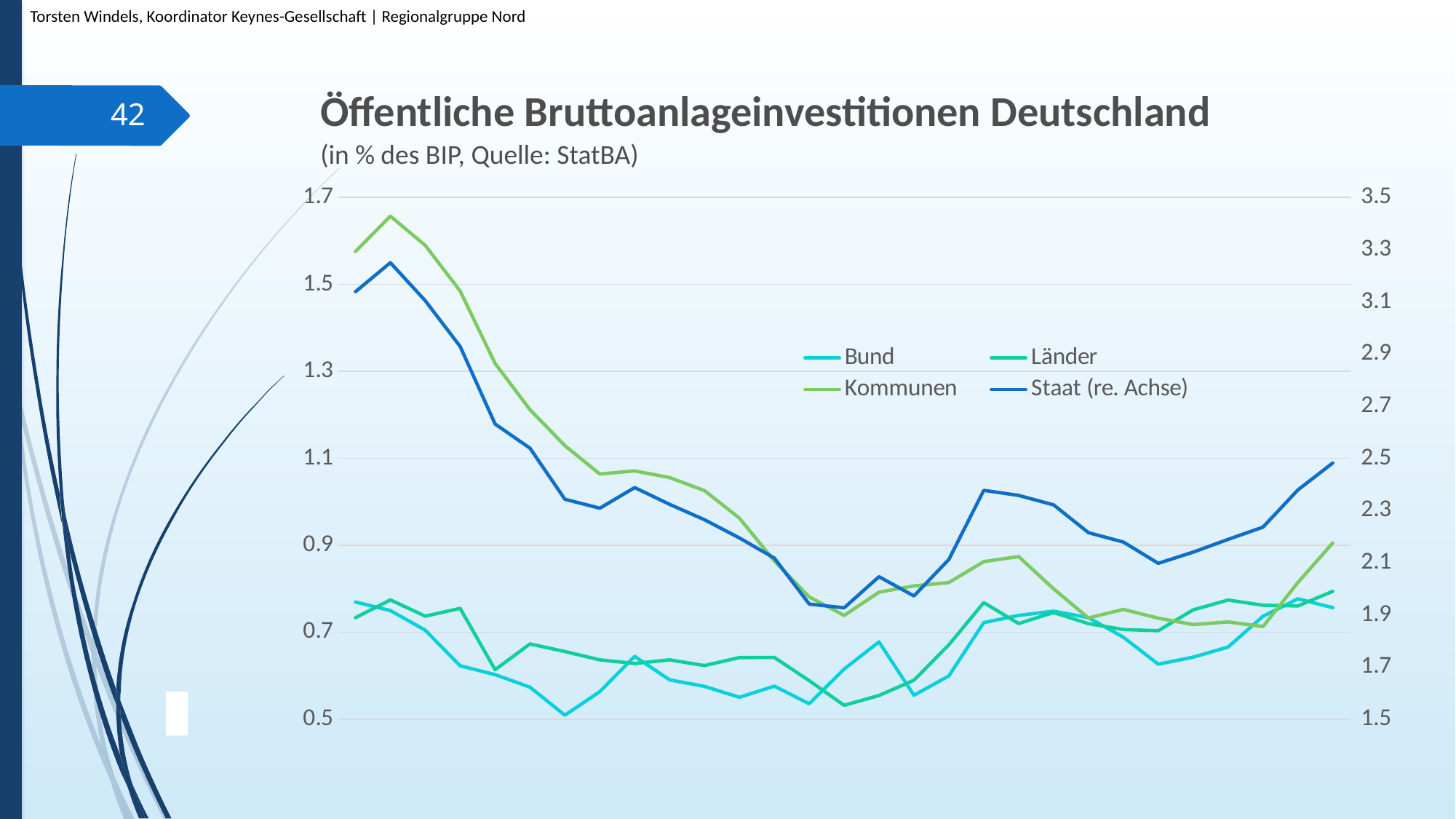
Is the last value of the Staat (re. Achse) series greater or less than 2.3 on the right axis? greater Is the first value of the Kommunen series greater or less than 1.5? greater What kind of chart is shown on the slide? line chart How many series does the legend list? 4 Is the lowest value of the Staat (re. Achse) series greater or less than 2.1 on the right axis? less Does the Kommunen series overall rise or fall from the start to the end of the chart? fall Among Bund, Länder and Kommunen, which series has the highest value at the start of the chart? Kommunen At the start of the chart, which is larger: the Kommunen value or the Bund value? Kommunen Which series is plotted against the right-hand axis according to the legend? Staat (re. Achse) What is the title of the chart? Öffentliche Bruttoanlageinvestitionen Deutschland Does the Staat (re. Achse) series overall rise or fall from the start to the end of the chart? fall